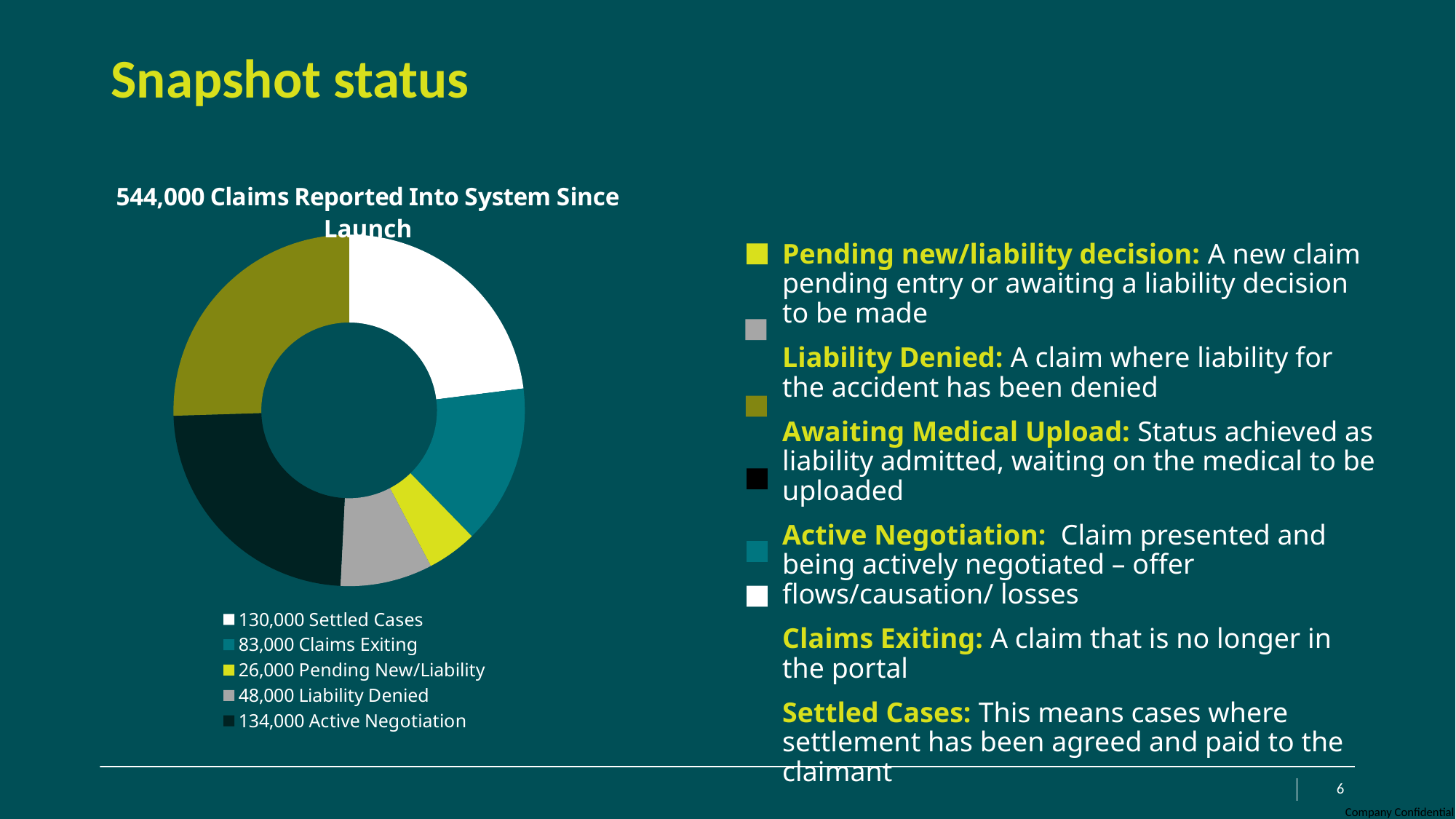
How many entries does the chart legend list? 5 How many claims are shown as Claims Exiting? 83,000 What kind of chart is shown on the slide? doughnut chart Which is larger, Claims Exiting or Liability Denied? Claims Exiting What is the title of the chart? 544,000 Claims Reported Into System Since Launch What is the difference between the Active Negotiation and Settled Cases values? 4,000 Which legend category has the largest number of claims? Active Negotiation What is the difference between Claims Exiting and Liability Denied? 35,000 What is the number of claims in Active Negotiation according to the chart? 134,000 How many claims are listed as Settled Cases in the chart legend? 130,000 How many claims are shown as Liability Denied? 48,000 Which legend category has the smallest number of claims? Pending New/Liability